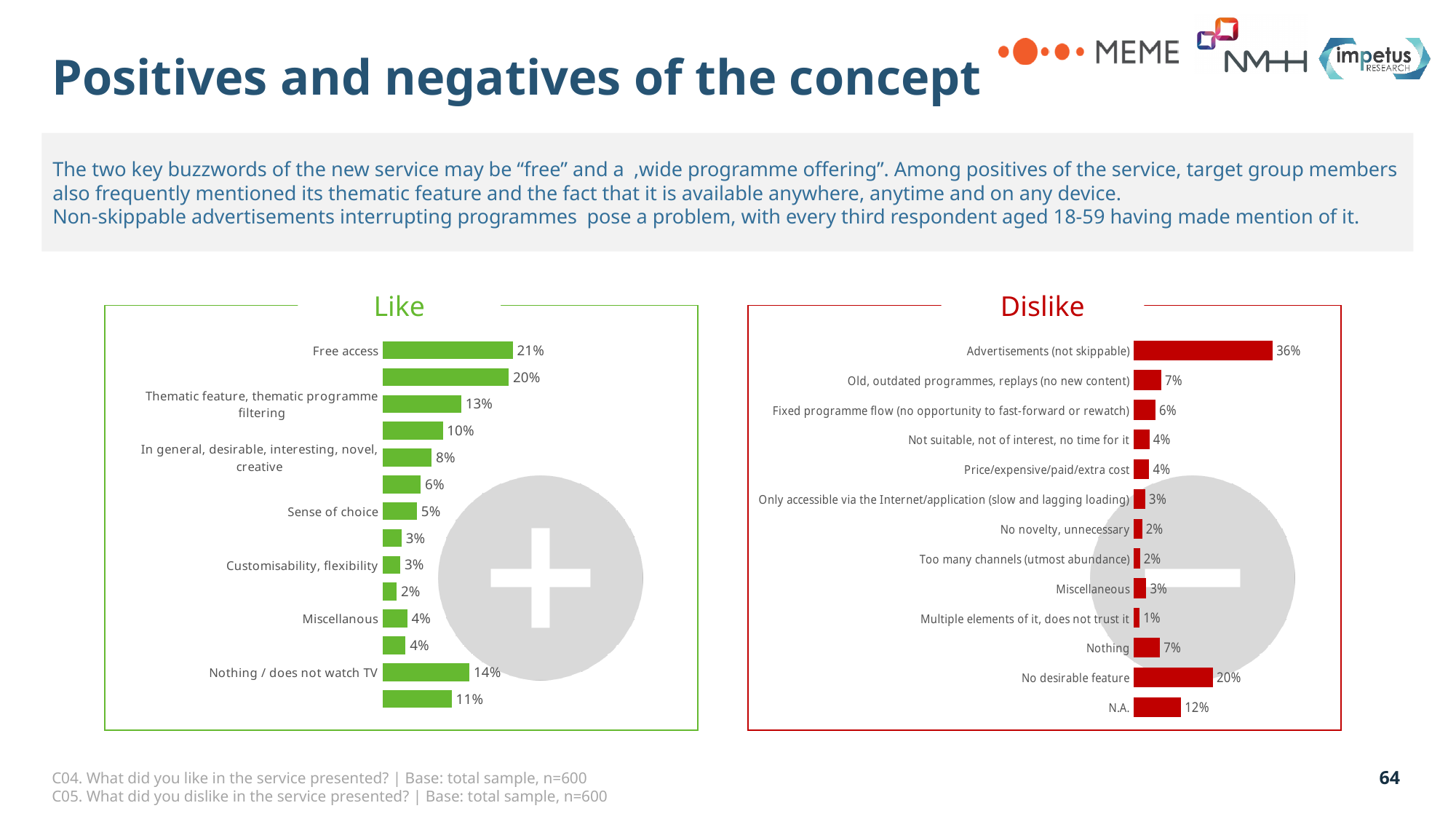
In the Like chart, what percentage is shown for Nothing / does not watch TV? 14% In the Like chart, which is larger: Thematic feature, thematic programme filtering or Sense of choice? Thematic feature, thematic programme filtering In the Dislike chart, which category has the highest value? Advertisements (not skippable) In the Dislike chart, which category has the lowest value? Multiple elements of it, does not trust it In the Like chart, what percentage is shown for Free access? 21% In the Dislike chart, what percentage is shown for No desirable feature? 20% What type of chart is the Dislike chart? Bar chart In the Like chart, which category has the highest value? Free access In the Dislike chart, what is the difference between Advertisements (not skippable) and No desirable feature? 16% How many categories are shown in the Dislike chart? 13 In the Dislike chart, what percentage is shown for Advertisements (not skippable)? 36% What colour are the bars in the Like chart? Green